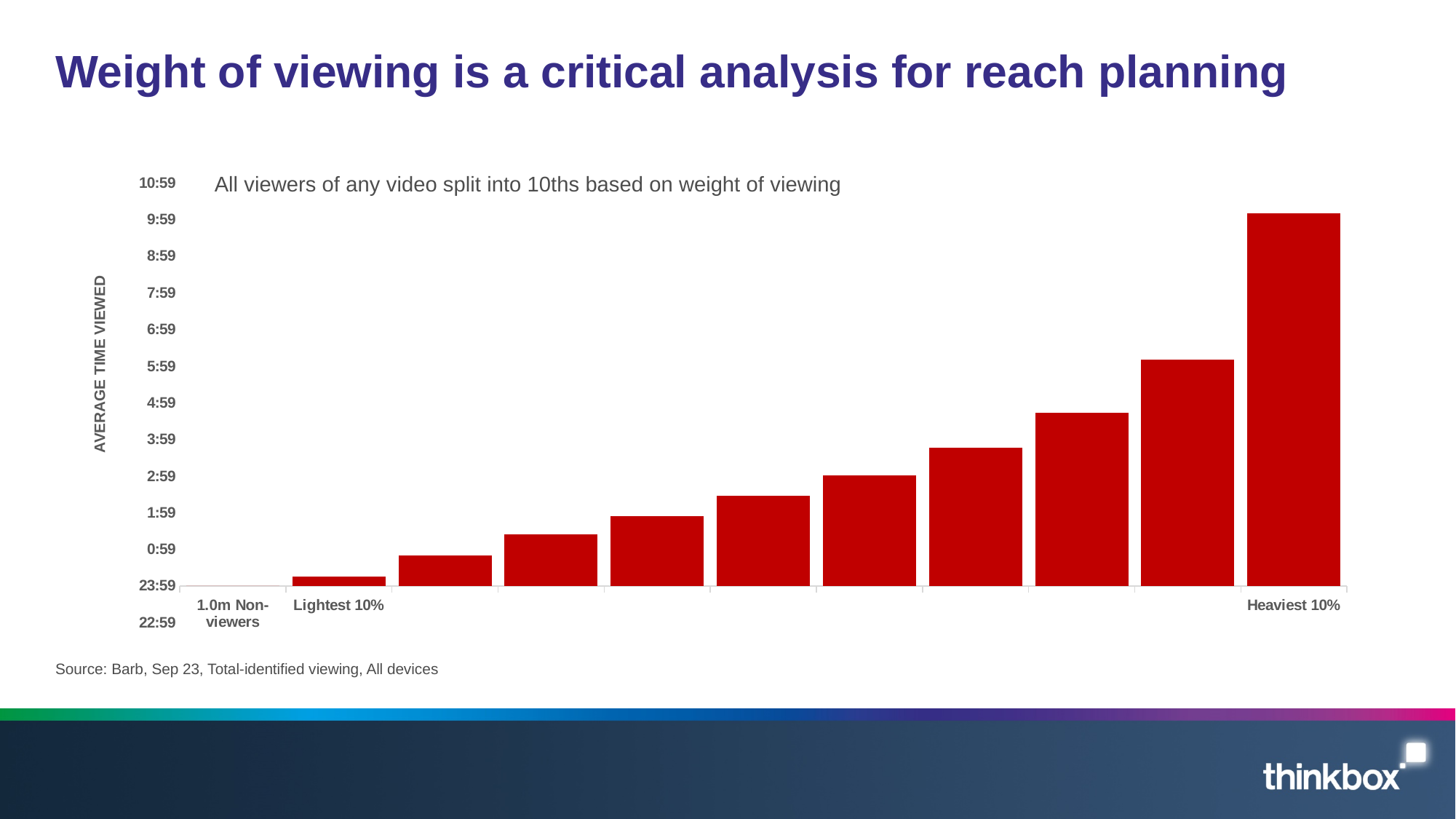
Which category has the highest average time viewed? Heaviest 10% What kind of chart is shown on the slide? bar chart Which of the labelled viewer groups has the lowest bar among the red bars? Lightest 10% Which is larger, the average time viewed for Heaviest 10% or for Lightest 10%? Heaviest 10% Is the value for Heaviest 10% greater or less than 8:59? greater What is the label on the vertical axis of the chart? AVERAGE TIME VIEWED Is the value for Lightest 10% greater or less than 0:59? less Do the bars rise or fall moving from left to right along the x axis? rise How many categories are marked along the x axis, including the non-viewers group? 11 What is the subtitle text shown above the chart? All viewers of any video split into 10ths based on weight of viewing